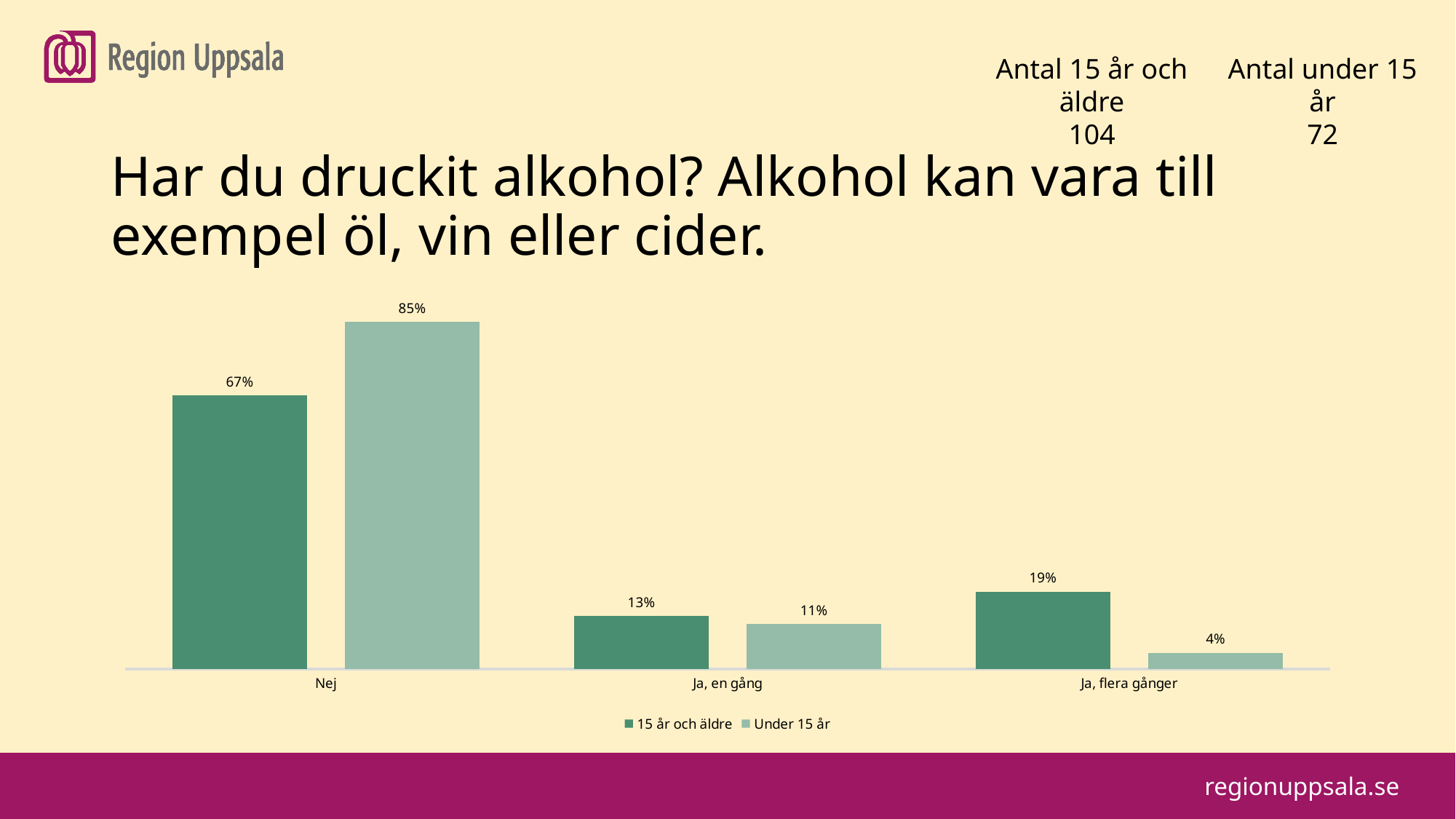
What is the value for "Ja, flera gånger" in the "Under 15 år" series? 4% Which category has the highest value in the "Under 15 år" series? Nej Which category has the lowest value in the "15 år och äldre" series? Ja, en gång How many series does the legend list? 2 How many categories are shown on the x axis? 3 What is the difference between the "Under 15 år" and "15 år och äldre" values for "Nej"? 18% Which series has the larger value for "Ja, flera gånger"? 15 år och äldre What is the difference between the "15 år och äldre" and "Under 15 år" values for "Ja, flera gånger"? 15% What is the value for "Nej" in the "Under 15 år" series? 85% What is the value for "Ja, en gång" in the "15 år och äldre" series? 13% What is the value for "Nej" in the "15 år och äldre" series? 67% What kind of chart is shown on the slide? Bar chart